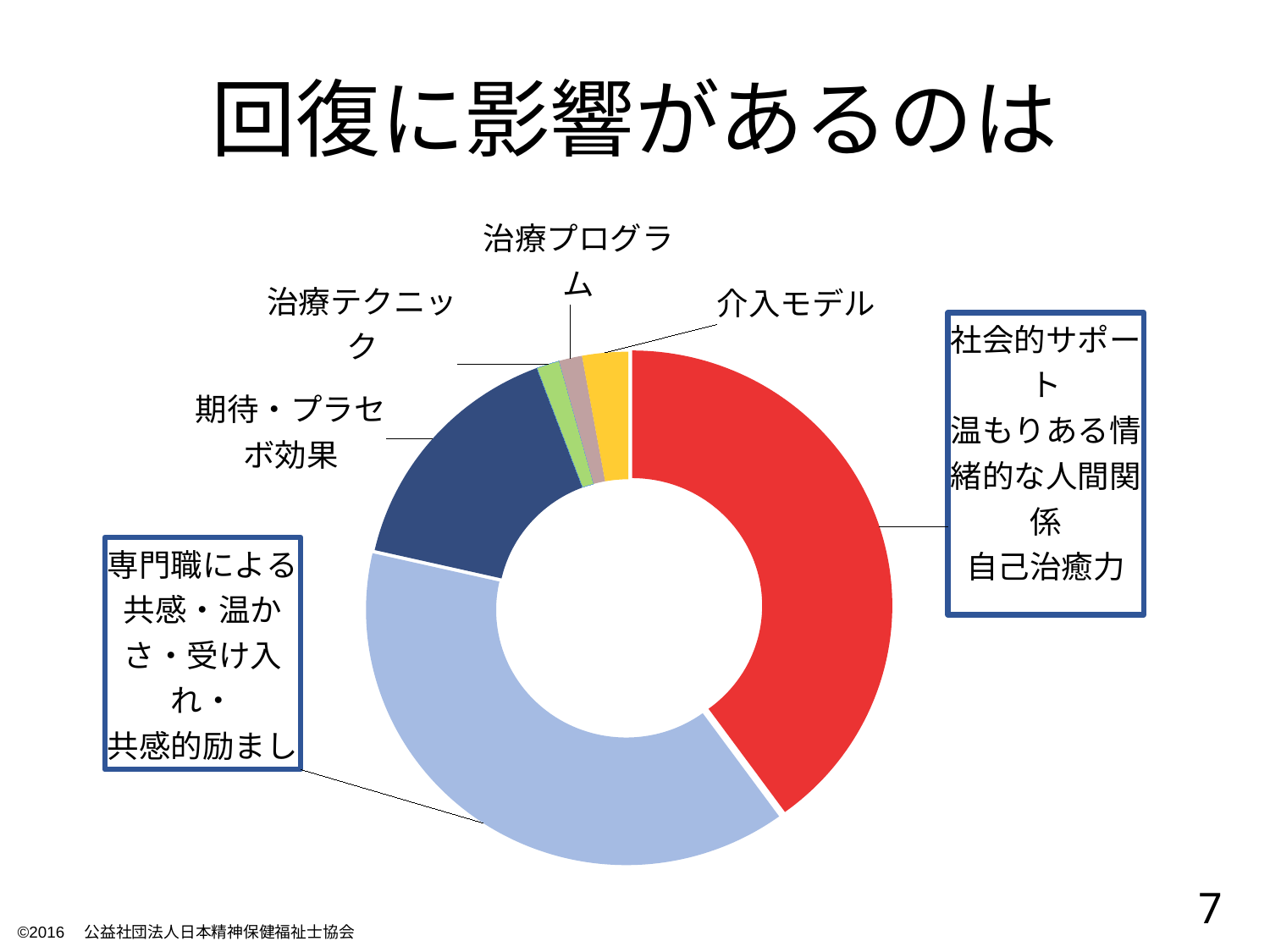
What colour is the slice for 社会的サポート・温もりある情緒的な人間関係・自己治癒力? Red Which slice is larger: 専門職による共感・温かさ・受け入れ・共感的励まし or 期待・プラセボ効果? 専門職による共感・温かさ・受け入れ・共感的励まし What is the title of the slide containing the chart? 回復に影響があるのは How many categories (slices) does the chart have? 6 Which slice is larger: 介入モデル or 治療テクニック? 介入モデル What kind of chart is shown on the slide? Doughnut (pie) chart Which slice is larger: 期待・プラセボ効果 or 介入モデル? 期待・プラセボ効果